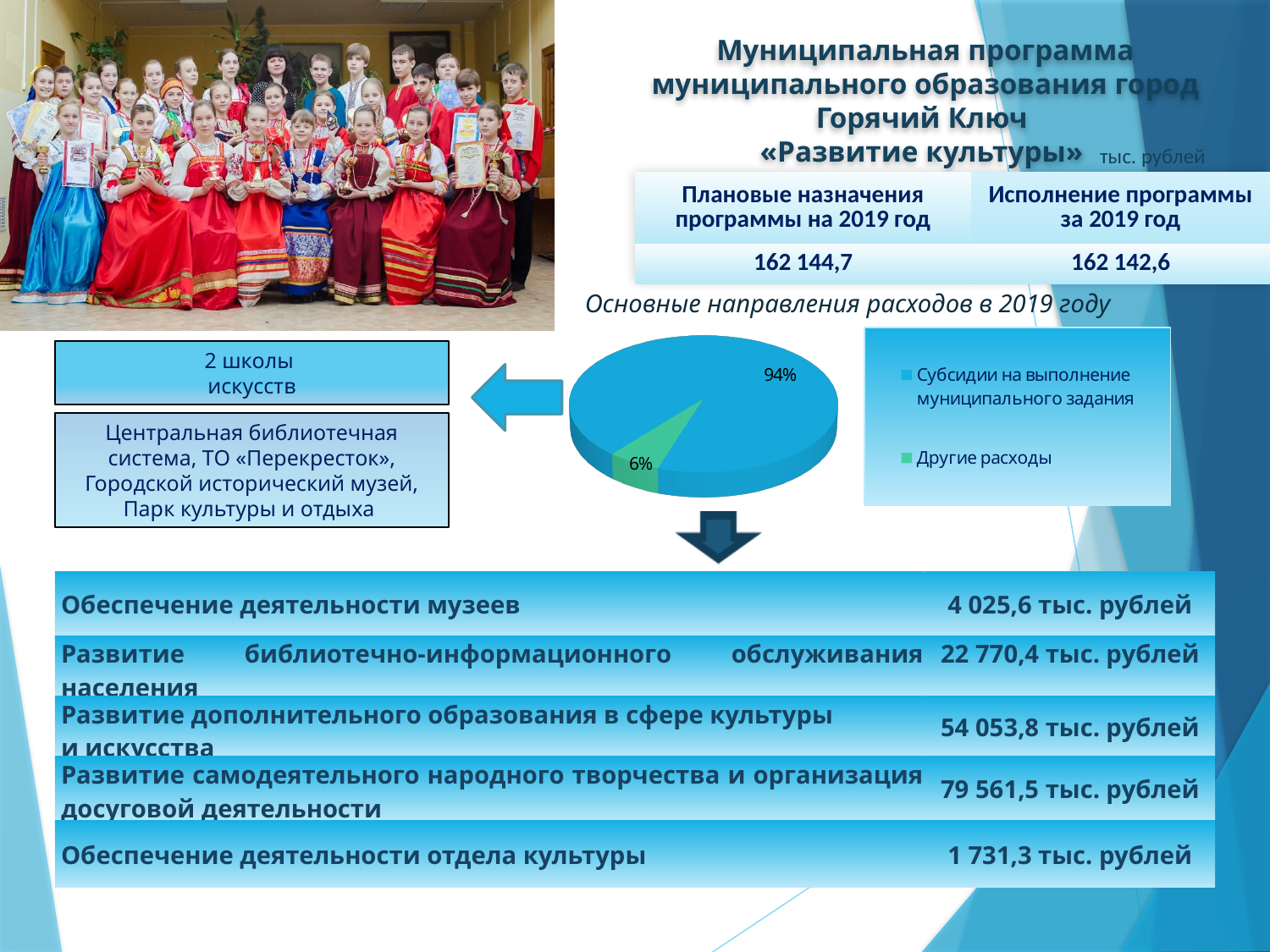
What is the heading shown directly above the pie chart? Основные направления расходов в 2019 году By how many percentage points does the «Субсидии на выполнение муниципального задания» slice exceed the «Другие расходы» slice? 88 What share of the pie chart does «Субсидии на выполнение муниципального задания» take? 94% How many entries does the legend of the pie chart list? 2 What colour is the «Другие расходы» slice in the pie chart? Green How many slices does the pie chart have? 2 Which slice of the pie chart is the smallest? Другие расходы Which is larger in the pie chart: «Субсидии на выполнение муниципального задания» or «Другие расходы»? Субсидии на выполнение муниципального задания What share of the pie chart does «Другие расходы» take? 6% What kind of chart is shown on the slide? Pie chart Which slice of the pie chart is the largest? Субсидии на выполнение муниципального задания